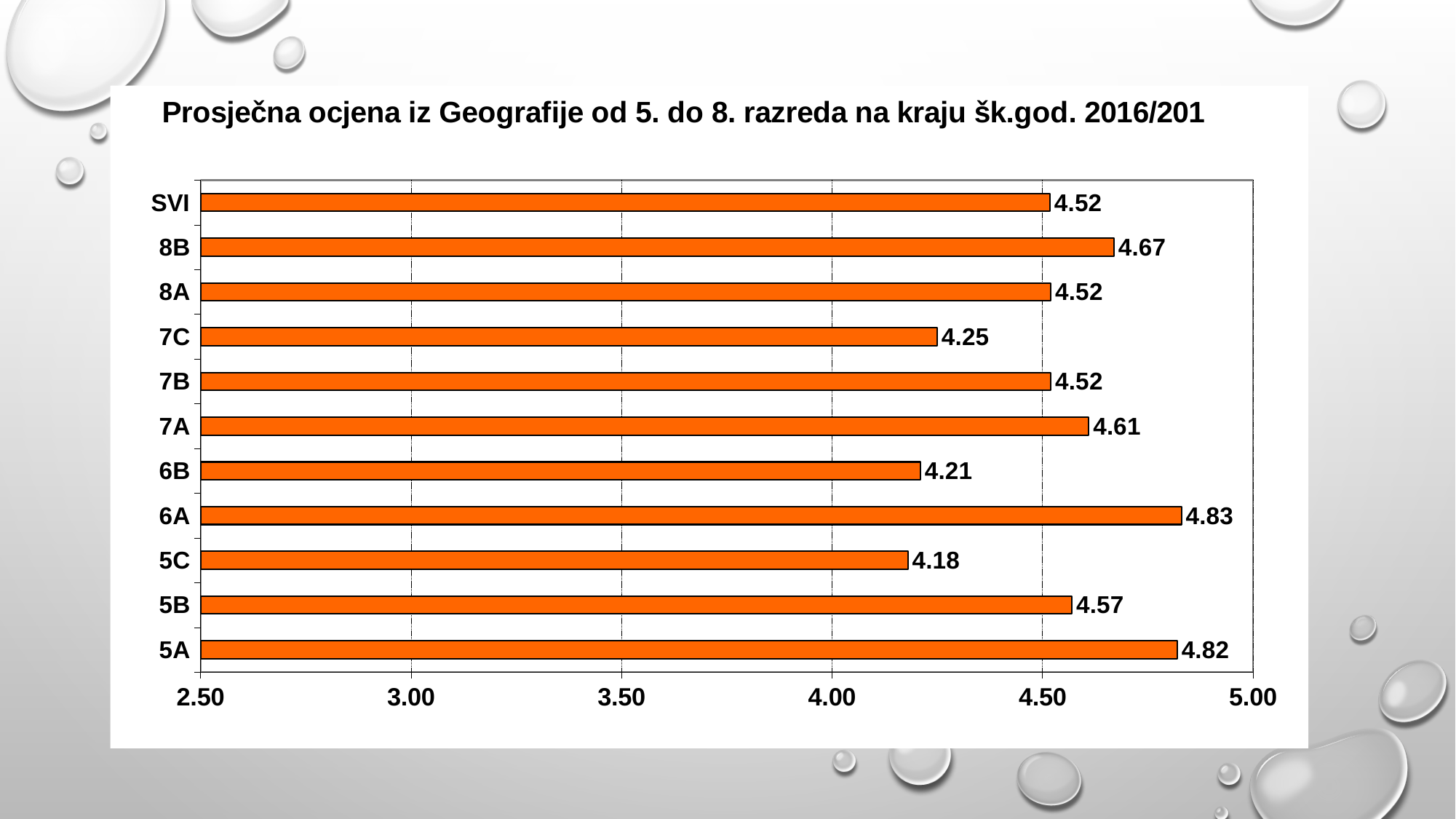
What is the value for 6A? 4.83 Which category has the highest value? 6A What is the title of the chart? Prosječna ocjena iz Geografije od 5. do 8. razreda na kraju šk.god. 2016/201 What kind of chart is this? bar chart What is the difference between the values for 6A and 6B? 0.62 What is the value for 5C? 4.18 How many categories are shown on the chart? 11 Which is larger, the value for 7A or the value for 7C? 7A What is the value for SVI? 4.52 What is the difference between the values for 8B and 8A? 0.15 Is the value for 5B greater or less than 4.50? greater Which category has the lowest value? 5C